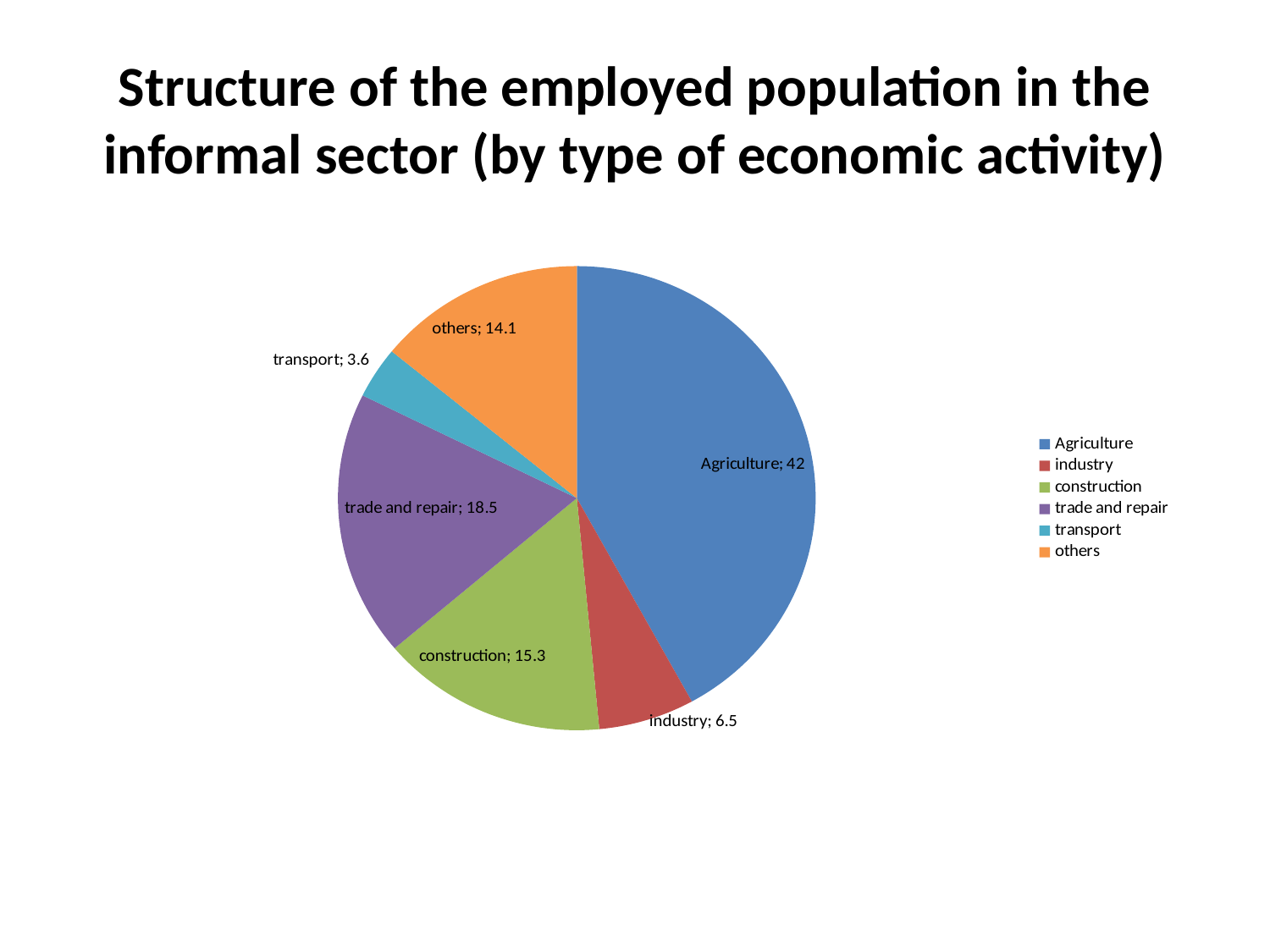
What type of chart is shown on the slide? pie chart How many categories are shown in the pie chart? 6 What is the value for Agriculture? 42 What is the difference between the values for trade and repair and construction? 3.2 What is the value for trade and repair? 18.5 Which category has the smallest slice? transport What is the value for transport? 3.6 What is the value for construction? 15.3 Which is larger, the value for others or the value for industry? others Which category has the largest slice? Agriculture What colour is the slice for trade and repair? purple What share of the pie does Agriculture represent? 42%